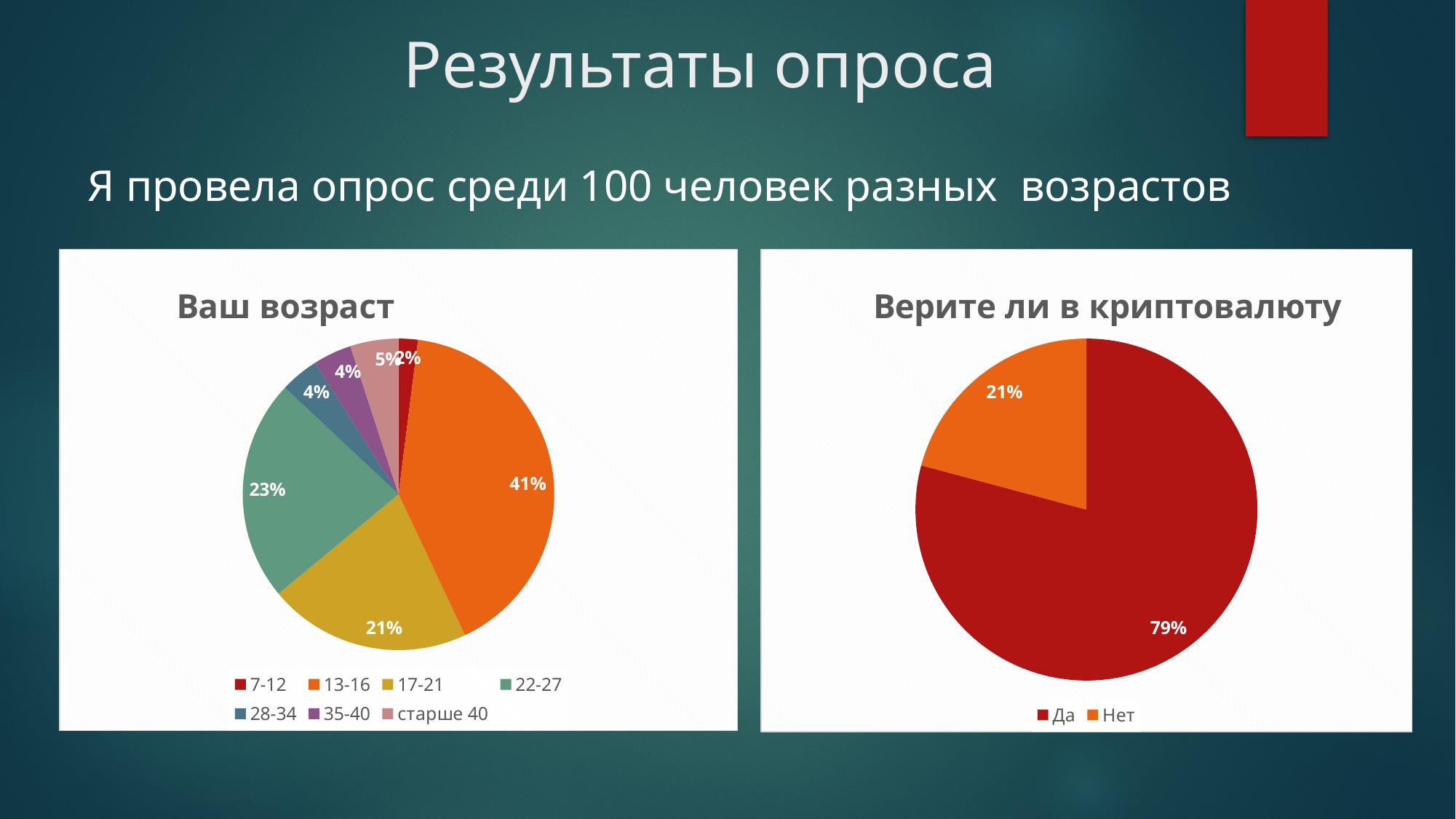
In the 'Верите ли в криптовалюту' chart, how many entries does the legend list? 2 In the 'Ваш возраст' chart, which is larger: the share for 22-27 or the share for 17-21? 22-27 In the 'Верите ли в криптовалюту' chart, what share of respondents answered 'Нет'? 21% In the 'Ваш возраст' chart, what is the difference between the shares for 13-16 and 22-27? 18% In the 'Ваш возраст' chart, which age group has the largest share? 13-16 In the 'Верите ли в криптовалюту' chart, what share of respondents answered 'Да'? 79% What type of chart is the 'Верите ли в криптовалюту' chart? Pie chart In the 'Ваш возраст' chart, how many age groups are shown? 7 In the 'Ваш возраст' chart, which age group has the smallest share? 7-12 In the 'Ваш возраст' chart, what share of respondents are aged 13-16? 41% In the 'Ваш возраст' chart, what share of respondents are aged 22-27? 23% In the 'Ваш возраст' chart, what share of respondents are aged 17-21? 21%